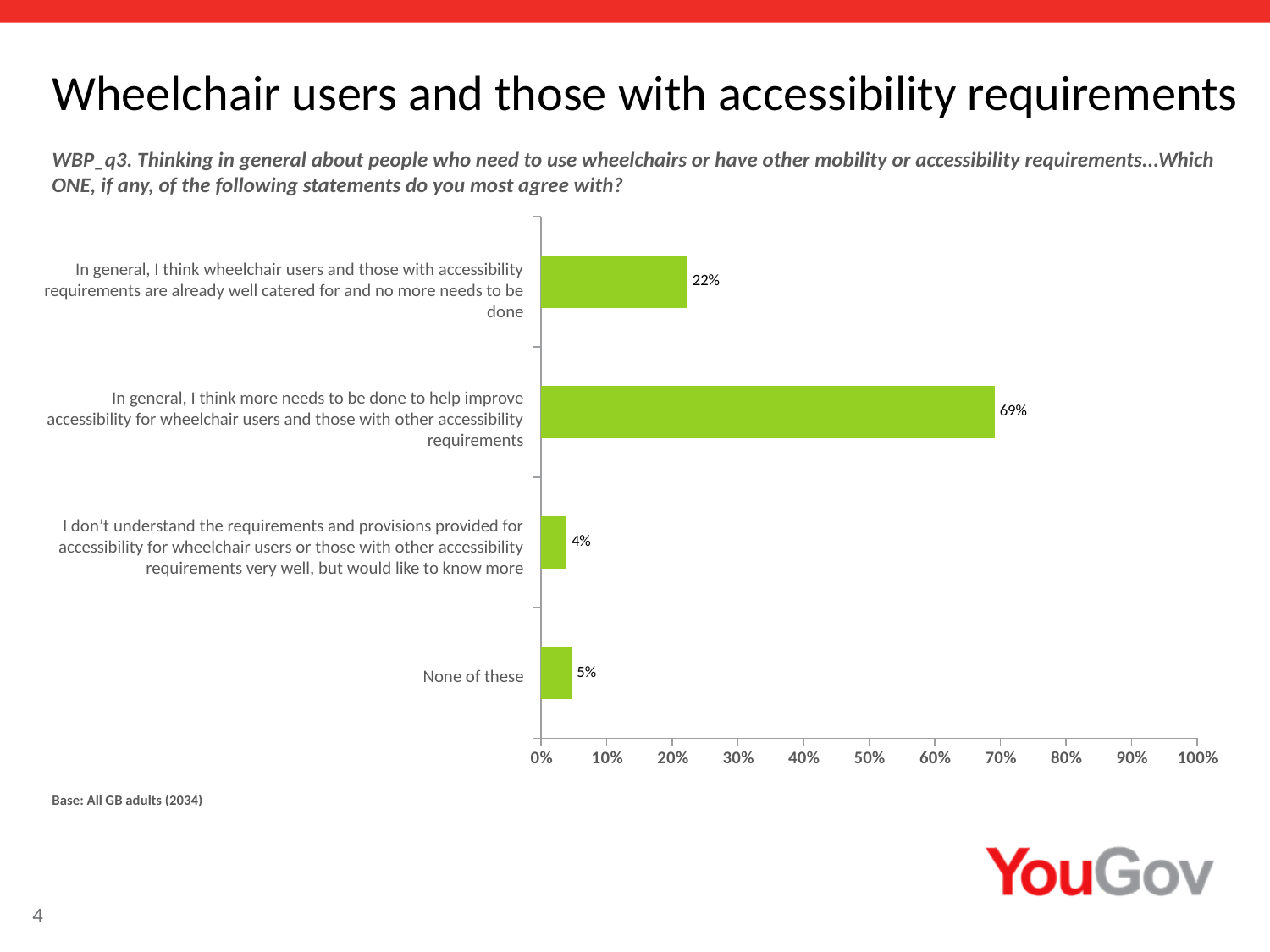
How many statements (categories) are shown in the chart? 4 What percentage of respondents think wheelchair users and those with accessibility requirements are already well catered for and no more needs to be done? 22% Which statement received the lowest share of agreement? I don't understand the requirements and provisions provided for accessibility for wheelchair users or those with other accessibility requirements very well, but would like to know more What is the difference in percentage points between those who think more needs to be done and those who think wheelchair users are already well catered for? 47 percentage points Is the value for 'already well catered for and no more needs to be done' greater or less than 30%? less Which is larger: the share choosing 'None of these' or the share saying they don't understand the requirements but would like to know more? None of these What percentage of respondents said they don't understand the requirements and provisions very well but would like to know more? 4% What percentage of respondents chose 'None of these'? 5% What type of chart is shown on the slide? Bar chart What percentage of respondents said more needs to be done to help improve accessibility for wheelchair users and those with other accessibility requirements? 69% Which statement received the highest share of agreement? In general, I think more needs to be done to help improve accessibility for wheelchair users and those with other accessibility requirements What is the base (sample size) stated below the chart? All GB adults (2034)